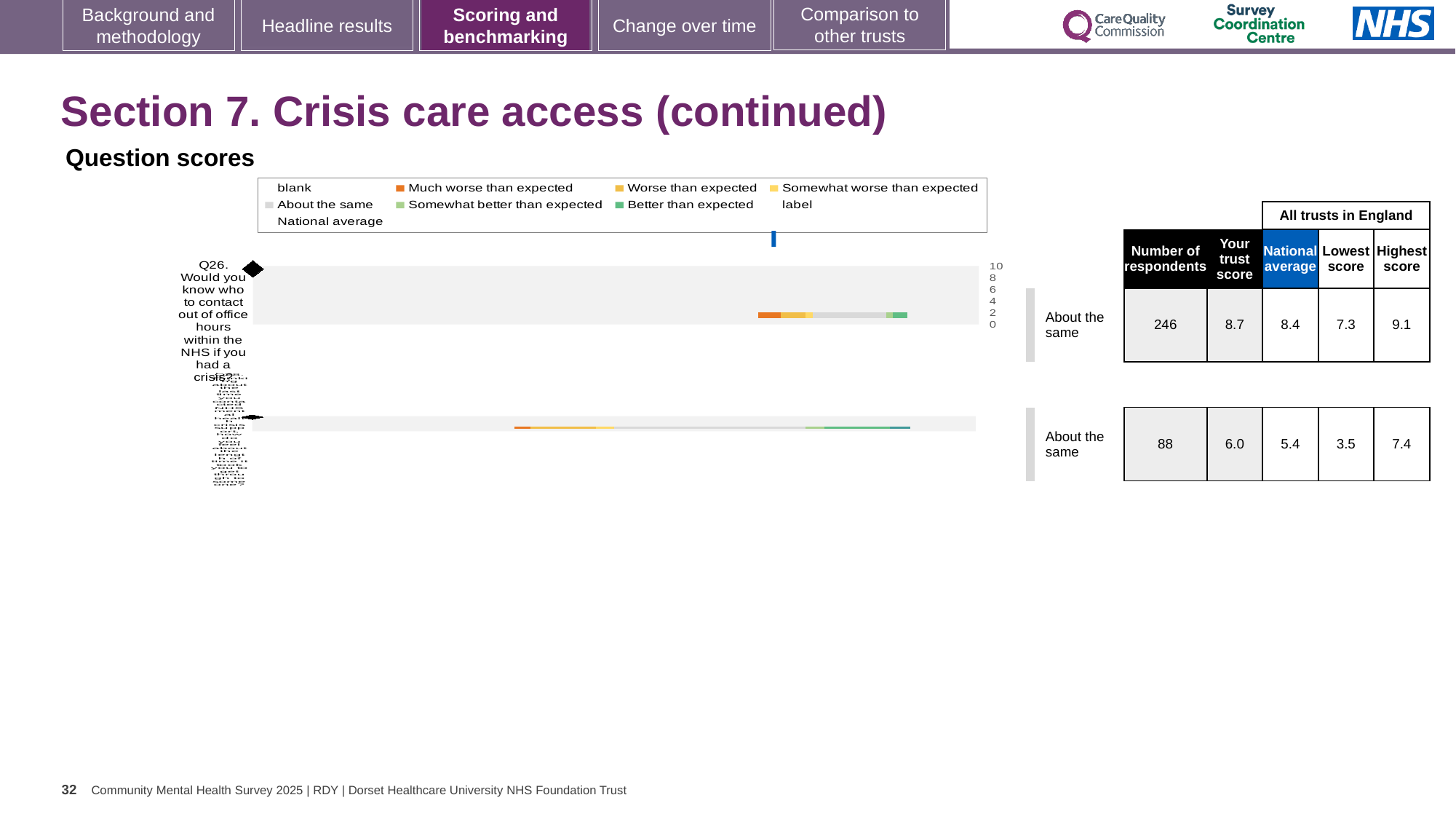
For Q26, what is the difference between the trust score and the national average? 0.3 What kind of chart is used to show the question scores on this slide? bar chart How many respondents answered Q26? 246 Is the trust score for Q26 greater or less than 8? greater What is the trust score for Q26 (Would you know who to contact out of office hours within the NHS if you had a crisis?)? 8.7 What is the national average score for Q26? 8.4 What benchmark category is shown for Q26? About the same For Q26, what is the difference between the highest and lowest scores among all trusts in England? 1.8 What is the highest score among all trusts in England for Q26? 9.1 What is the lowest score among all trusts in England for Q26? 7.3 For Q26, which is larger: the trust score or the national average? the trust score What colour does the legend use for 'Much worse than expected'? orange